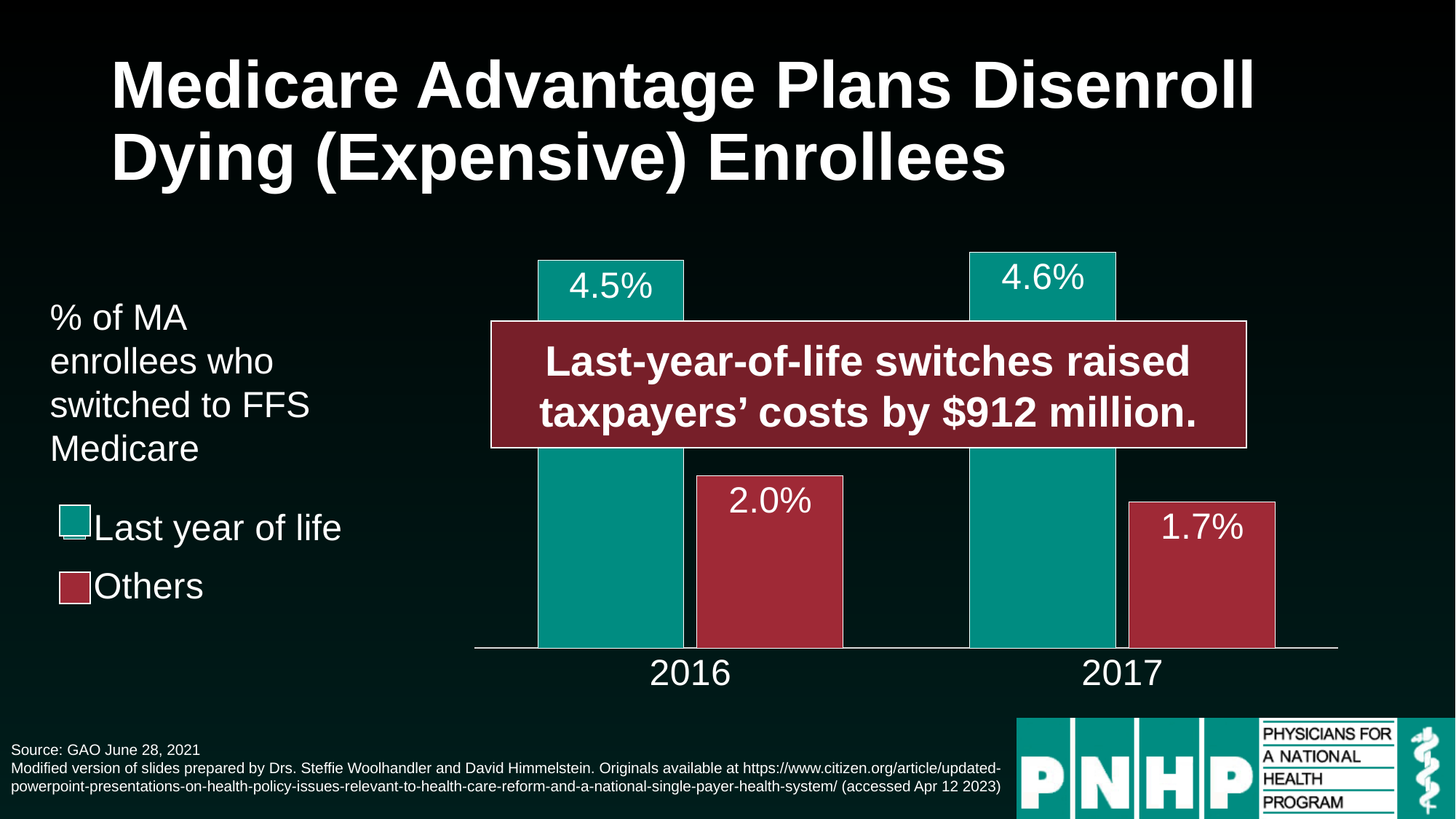
What is the value for Others in 2017? 1.7% What percentage of MA enrollees in their last year of life switched to FFS Medicare in 2016? 4.5% Which is larger in 2017: the Last year of life value or the Others value? Last year of life What is the value for Others in 2016? 2.0% Which bar on the chart has the highest value? Last year of life, 2017 How many years are shown on the x axis? 2 What kind of chart is shown on the slide? Bar chart What percentage of MA enrollees in their last year of life switched to FFS Medicare in 2017? 4.6% Which bar on the chart has the lowest value? Others, 2017 What is the difference between the Others values for 2016 and 2017? 0.3% How many series does the legend list? 2 What is the difference between the Last year of life and Others values in 2016? 2.5%